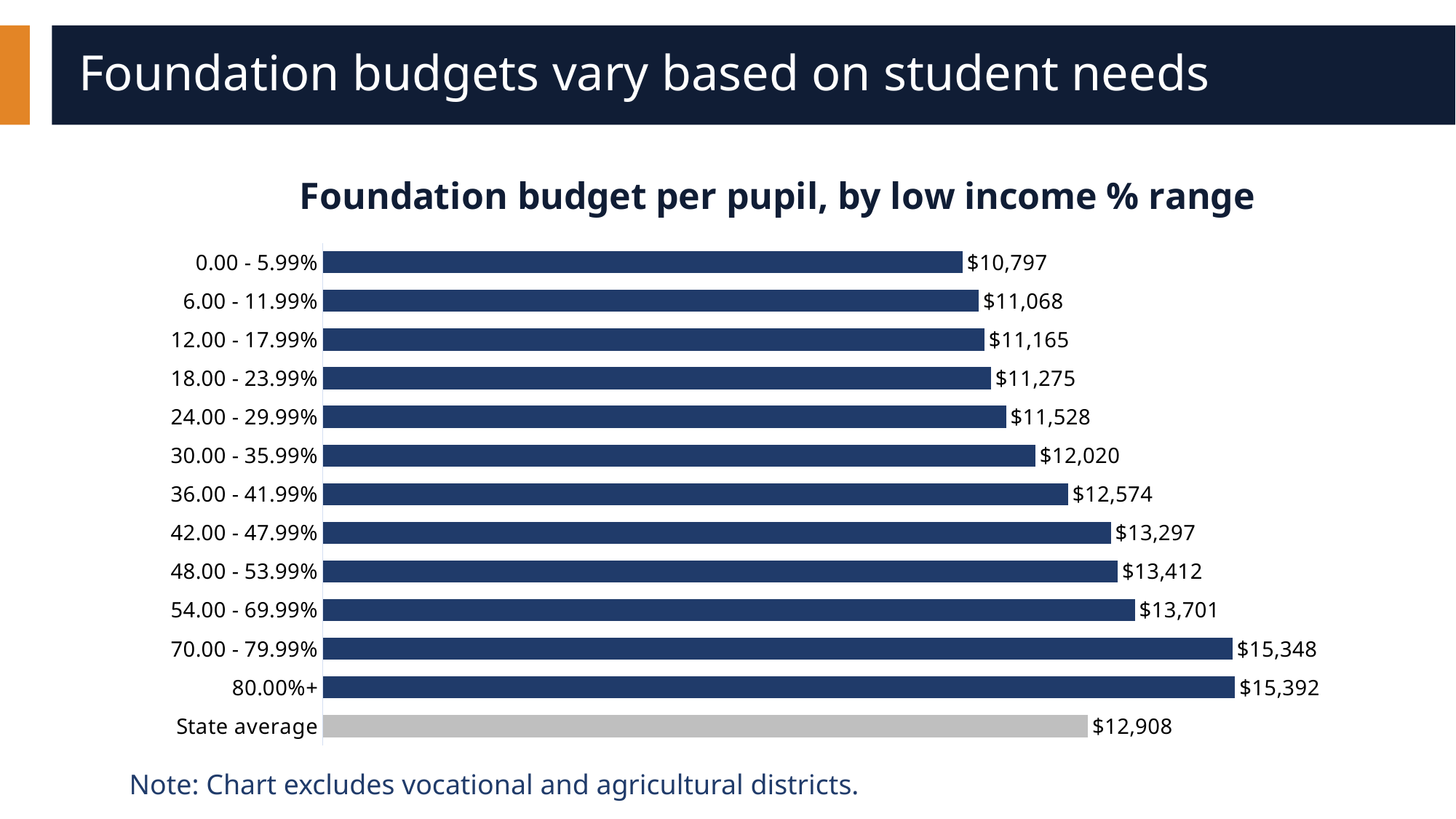
What is the title of the chart? Foundation budget per pupil, by low income % range Do the foundation budgets per pupil rise or fall as the low income % range increases? Rise What is the State average foundation budget per pupil? $12,908 What is the foundation budget per pupil for the 0.00 - 5.99% low income range? $10,797 Which low income % range has the highest foundation budget per pupil? 80.00%+ Which low income % range has the lowest foundation budget per pupil? 0.00 - 5.99% What is the foundation budget per pupil for the 42.00 - 47.99% low income range? $13,297 How many bars are shown in the chart, including the State average? 13 What type of chart is shown on the slide? Bar chart Which is larger: the foundation budget per pupil for the 36.00 - 41.99% range or the State average? State average What is the difference between the foundation budget per pupil for the 70.00 - 79.99% range and the State average? $2,440 What is the difference between the foundation budget per pupil for the 80.00%+ range and the 0.00 - 5.99% range? $4,595